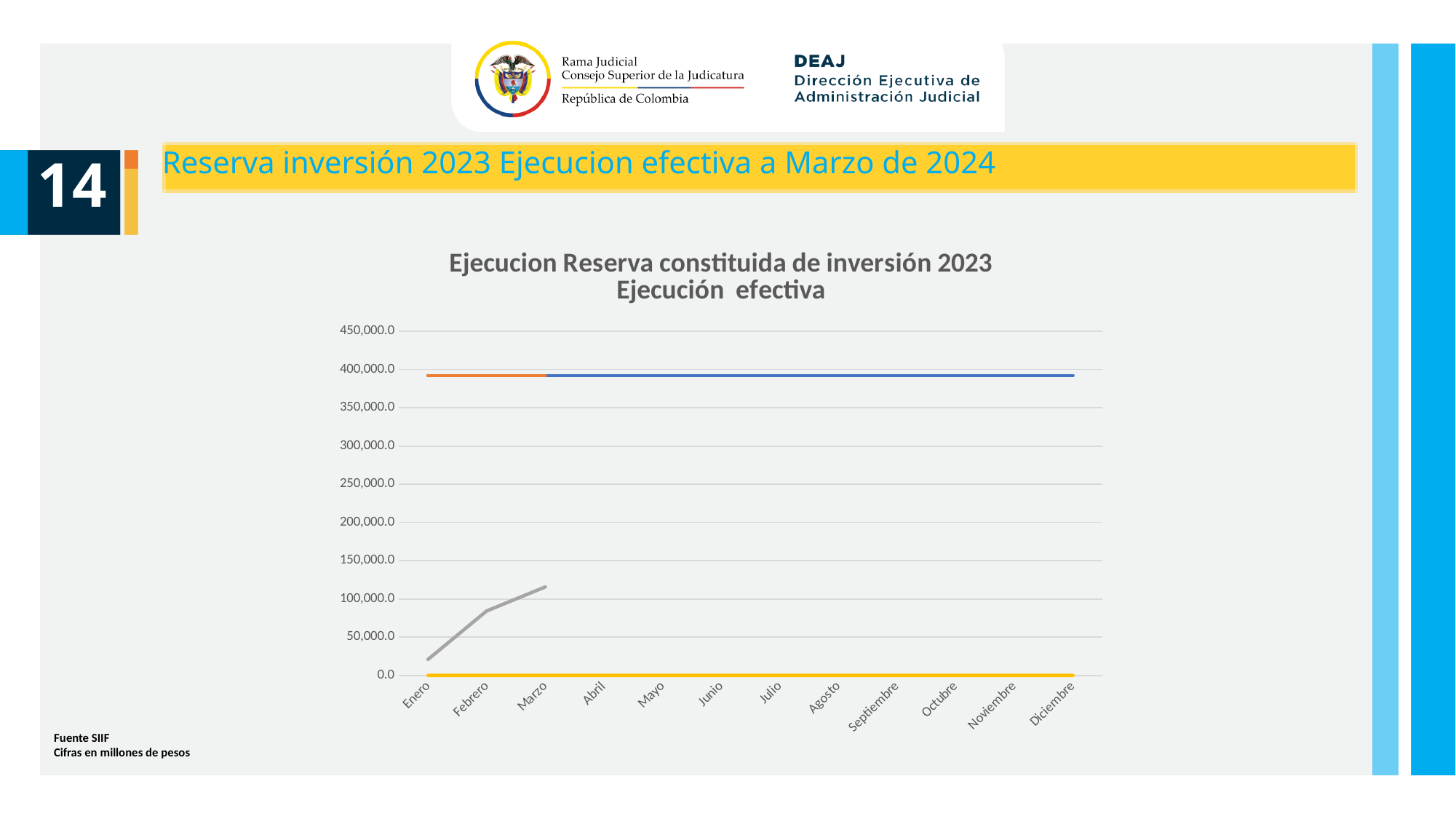
Is the value of the gray line in Marzo greater or less than 100,000? greater How many months are shown on the x axis of the chart? 12 What kind of chart is shown on the slide? Line chart Does the gray line rise or fall from Enero to Marzo? Rises Which month is the first category on the x axis? Enero What is the title of the chart? Ejecucion Reserva constituida de inversión 2023 Ejecución efectiva What is the highest value shown on the chart's y axis? 450,000.0 In which of the three months Enero, Febrero or Marzo does the gray line reach its highest value? Marzo Is the value of the gray line in Enero greater or less than 50,000? less Is the value of the flat orange and blue line greater or less than 350,000? greater Which month is the last category on the x axis? Diciembre